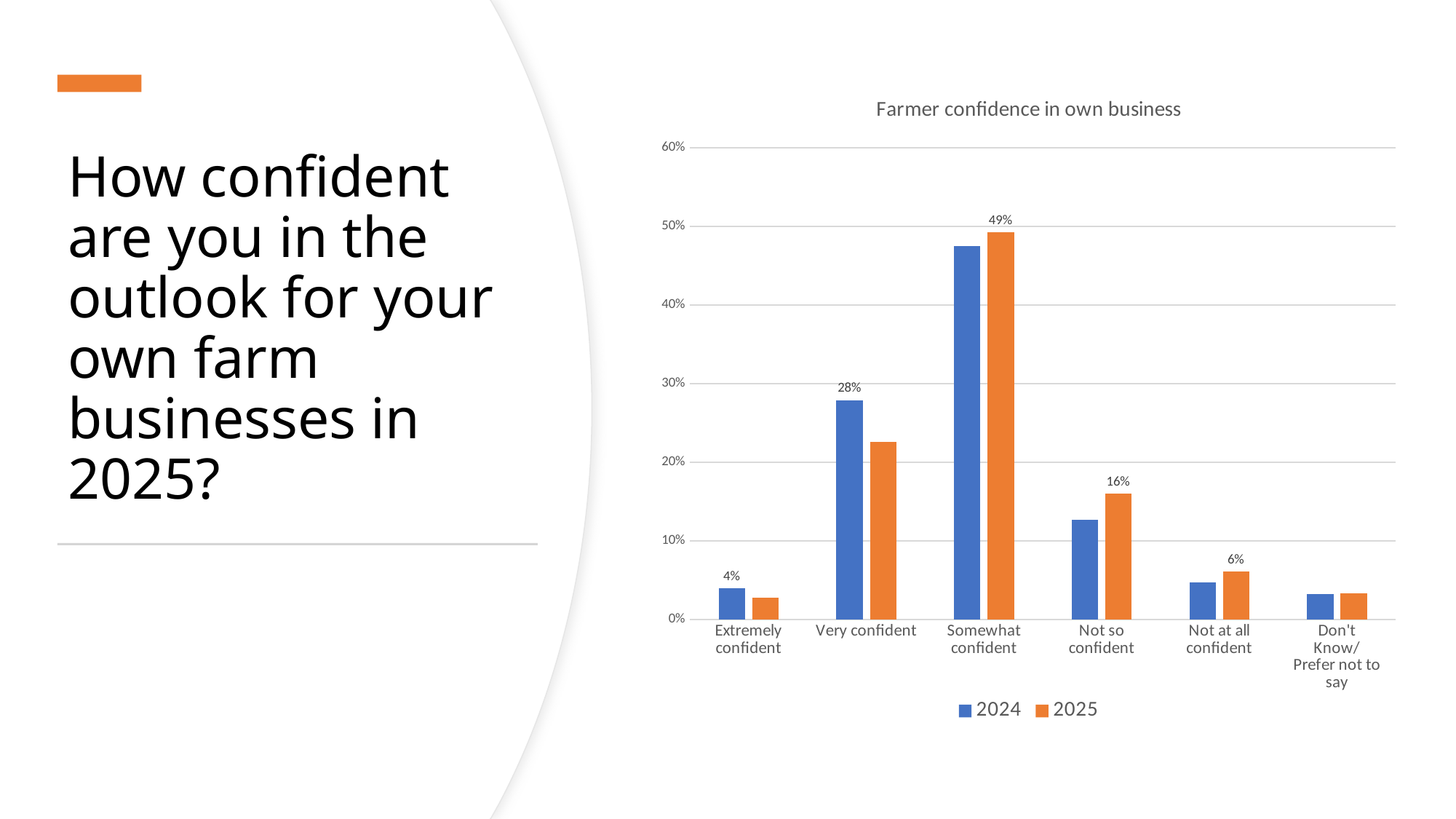
For Not so confident, which year has the larger value, 2024 or 2025? 2025 What is the 2024 value for Extremely confident? 4% How many series does the legend list? 2 How many categories are shown on the x axis? 6 For Very confident, which year has the larger value, 2024 or 2025? 2024 What is the 2025 value for Not so confident? 16% What is the 2025 value for Somewhat confident? 49% Is the 2024 value for Somewhat confident greater or less than 40%? greater What is the difference between the 2025 values for Somewhat confident and Not so confident? 33 percentage points What is the 2025 value for Not at all confident? 6% Which category has the highest value for 2025? Somewhat confident What is the 2024 value for Very confident? 28%